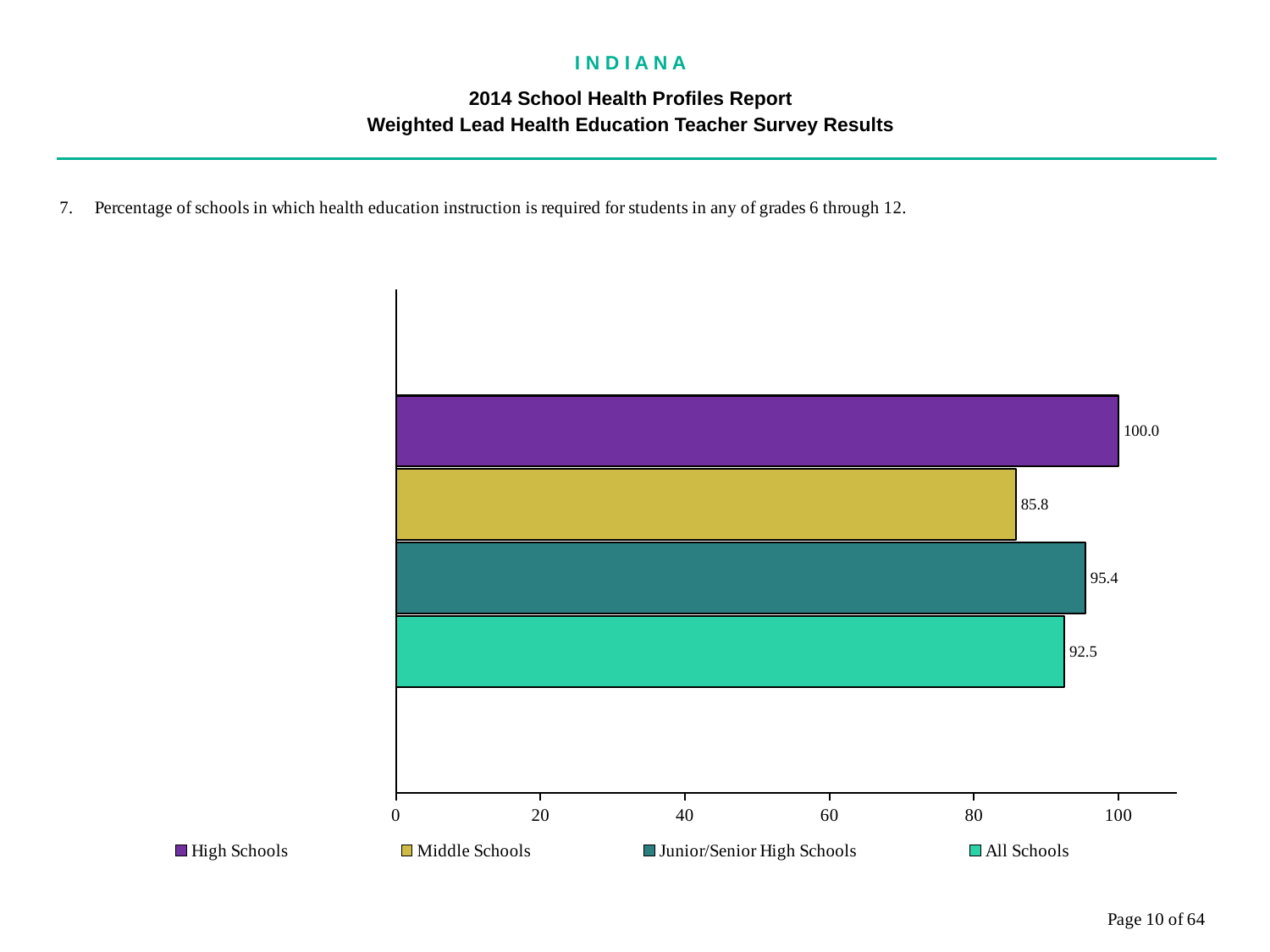
How many series does the legend list? 4 What is the difference between the values for Junior/Senior High Schools and All Schools? 2.9 Which school type has the highest value? High Schools What kind of chart is shown on the slide? Bar chart What colour is the bar for Middle Schools? Yellow Which school type has the lowest value? Middle Schools What is the value for Middle Schools? 85.8 Which is larger, the value for Junior/Senior High Schools or the value for All Schools? Junior/Senior High Schools What is the value for All Schools? 92.5 What is the difference between the values for High Schools and Middle Schools? 14.2 What is the value for Junior/Senior High Schools? 95.4 What is the value for High Schools? 100.0